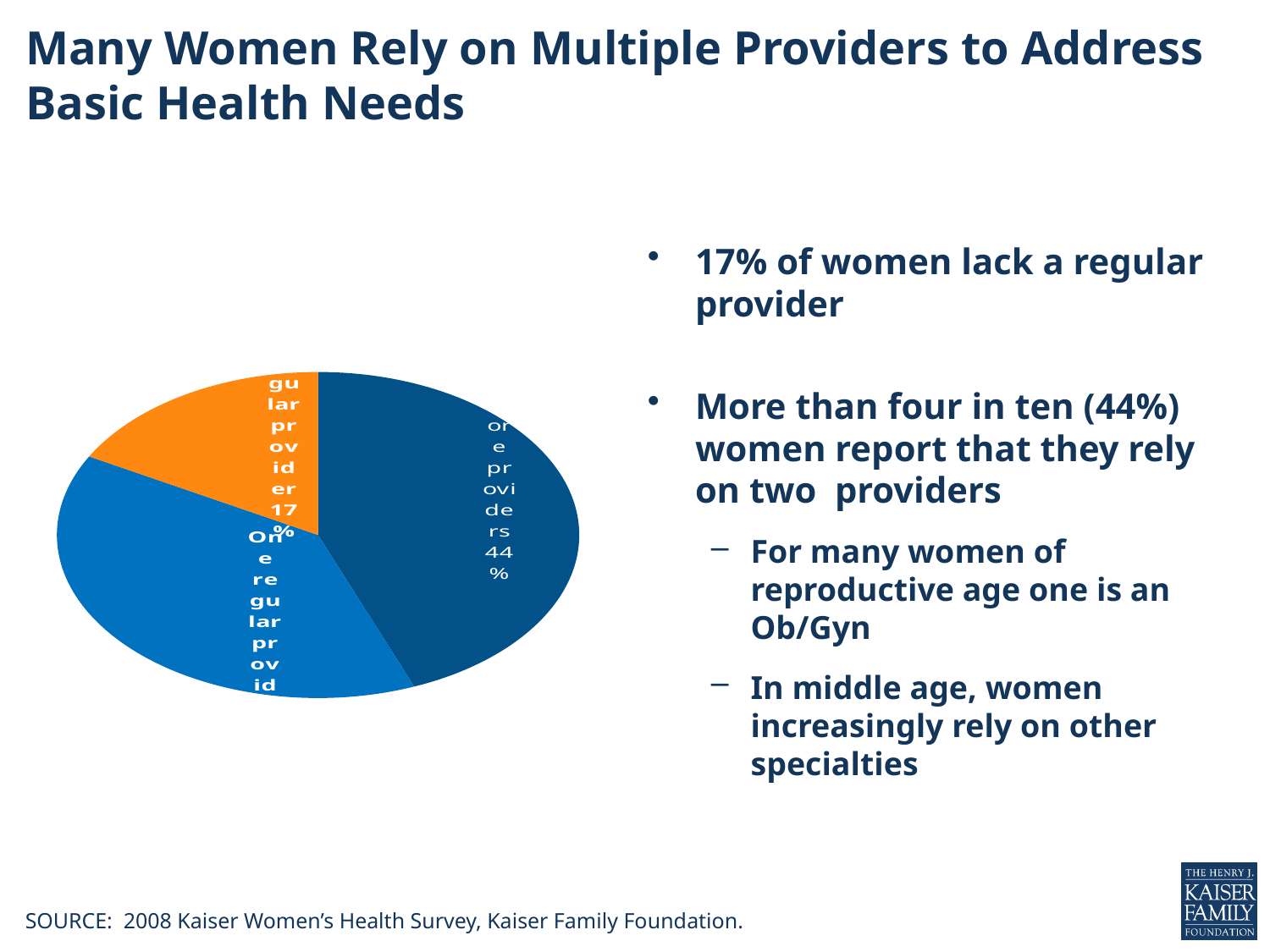
Which slice of the pie chart is the largest? the dark blue slice (44%) What value is printed on the dark blue slice of the pie chart? 44% What colour is the slice labeled 17%? orange What is the title of the slide containing the pie chart? Many Women Rely on Multiple Providers to Address Basic Health Needs What is the difference between the dark blue slice (44%) and the orange slice (17%)? 27 percentage points Which is larger, the dark blue slice or the orange slice? the dark blue slice What value is printed on the orange slice of the pie chart? 17% How many slices does the pie chart have? 3 Which slice of the pie chart is the smallest? the orange slice (17%) What kind of chart is shown on the slide? pie chart